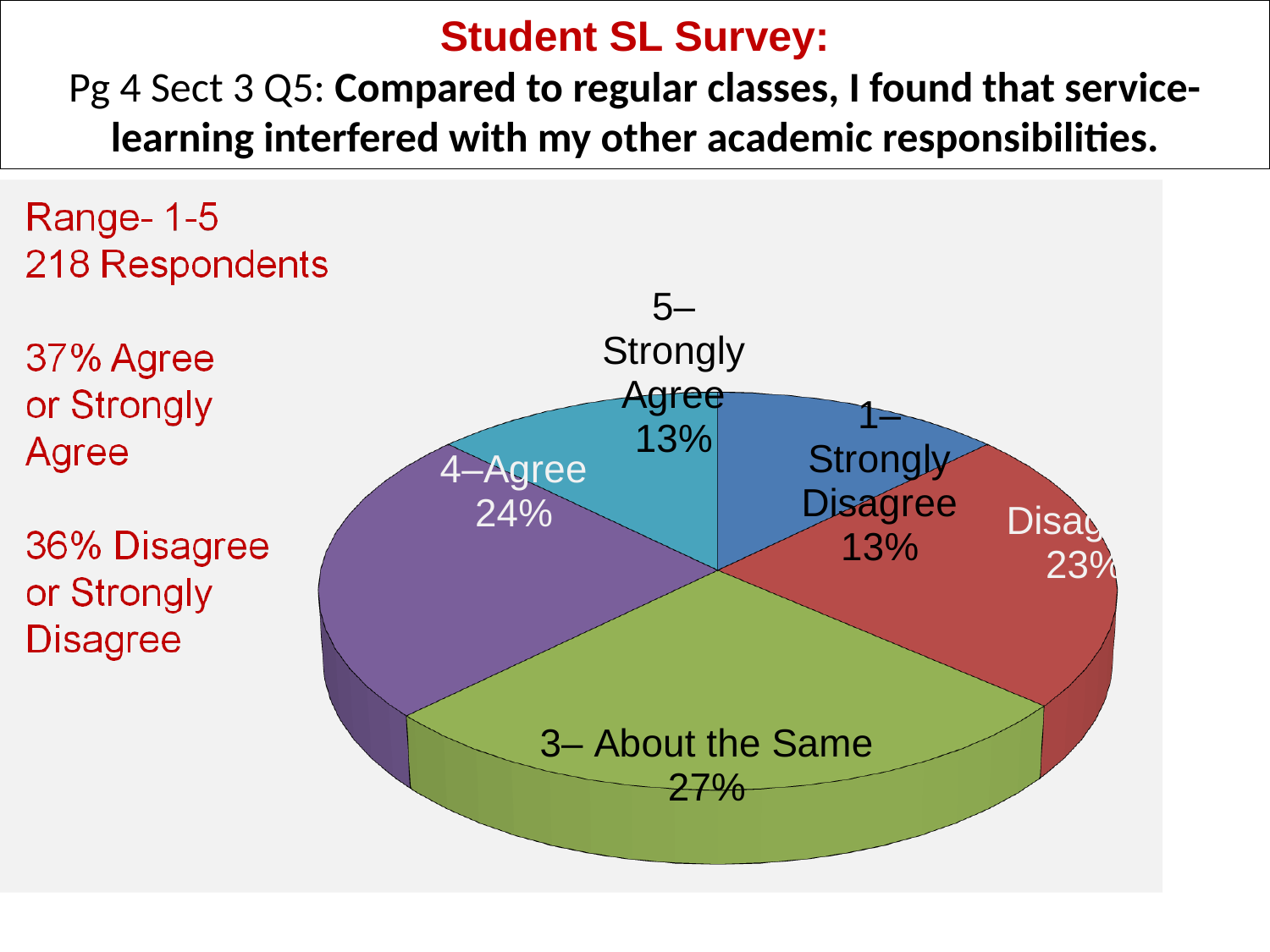
How many slices does the pie chart have? 5 Which is larger, the share for 4–Agree or the share for 5– Strongly Agree? 4–Agree How many respondents does the slide say took the survey? 218 What percentage of respondents chose 3– About the Same? 27% How many percentage points larger is the 3– About the Same share than the 4–Agree share? 3 What percentage of respondents chose 4–Agree? 24% What percentage of respondents chose 1– Strongly Disagree? 13% What percentage of respondents chose 5– Strongly Agree? 13% What colour is the 3– About the Same slice? green What is the combined share of 4–Agree and 5– Strongly Agree? 37% What kind of chart is shown on the slide? pie chart Which response category has the largest share of the pie? 3– About the Same